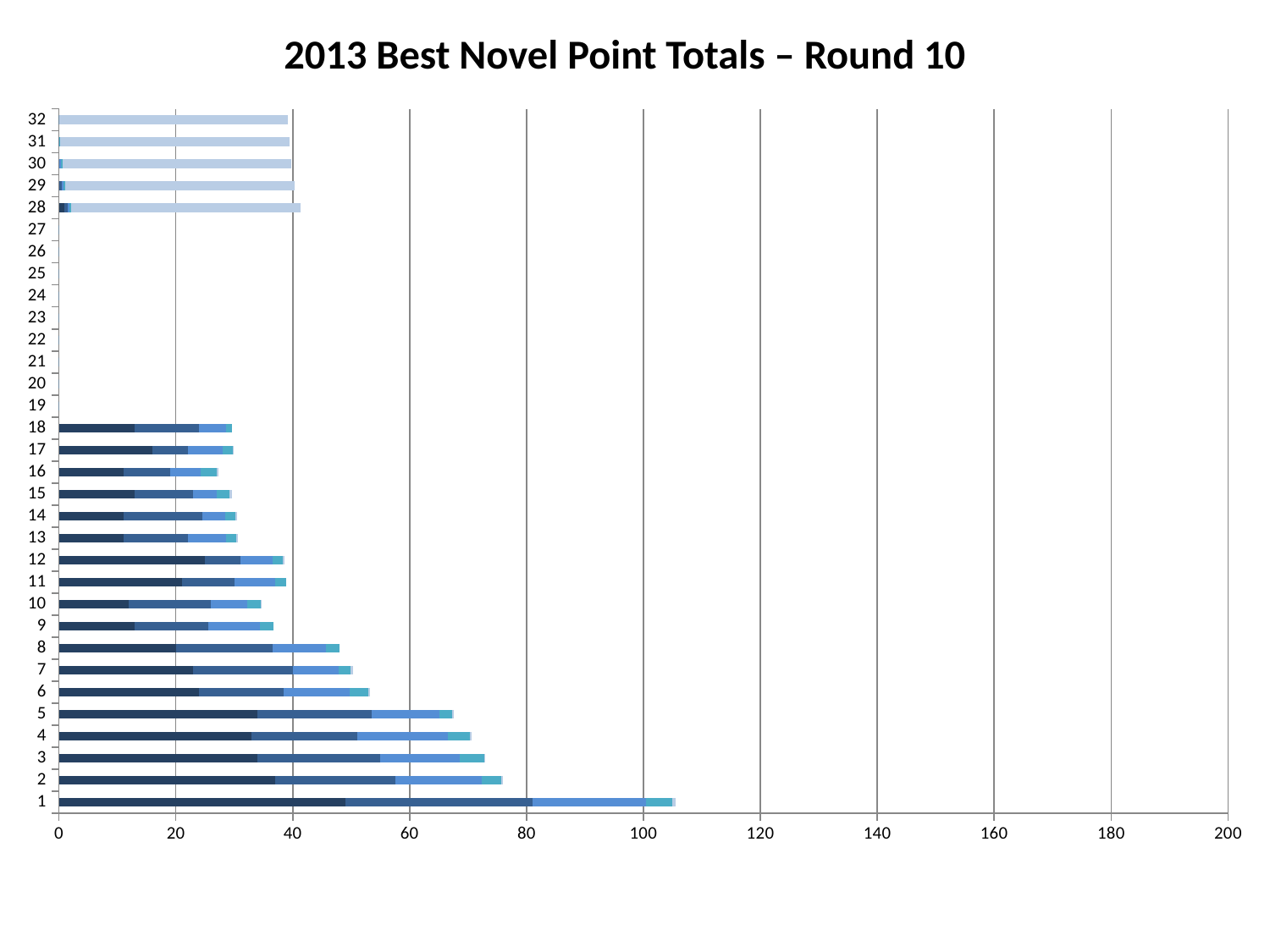
Which has the longer bar, category 12 or category 16? 12 What kind of chart is shown on the slide? bar chart What is the title of the chart? 2013 Best Novel Point Totals – Round 10 Is the total bar length for category 8 greater or less than 60? less Is the total bar length for category 16 greater or less than 20? greater How many categories are listed on the vertical axis of the chart? 32 What is the highest value shown on the horizontal axis? 200 Which has the longer bar, category 5 or category 8? 5 Is the total bar length for category 2 greater or less than 80? less Which category has the longest bar in the chart? 1